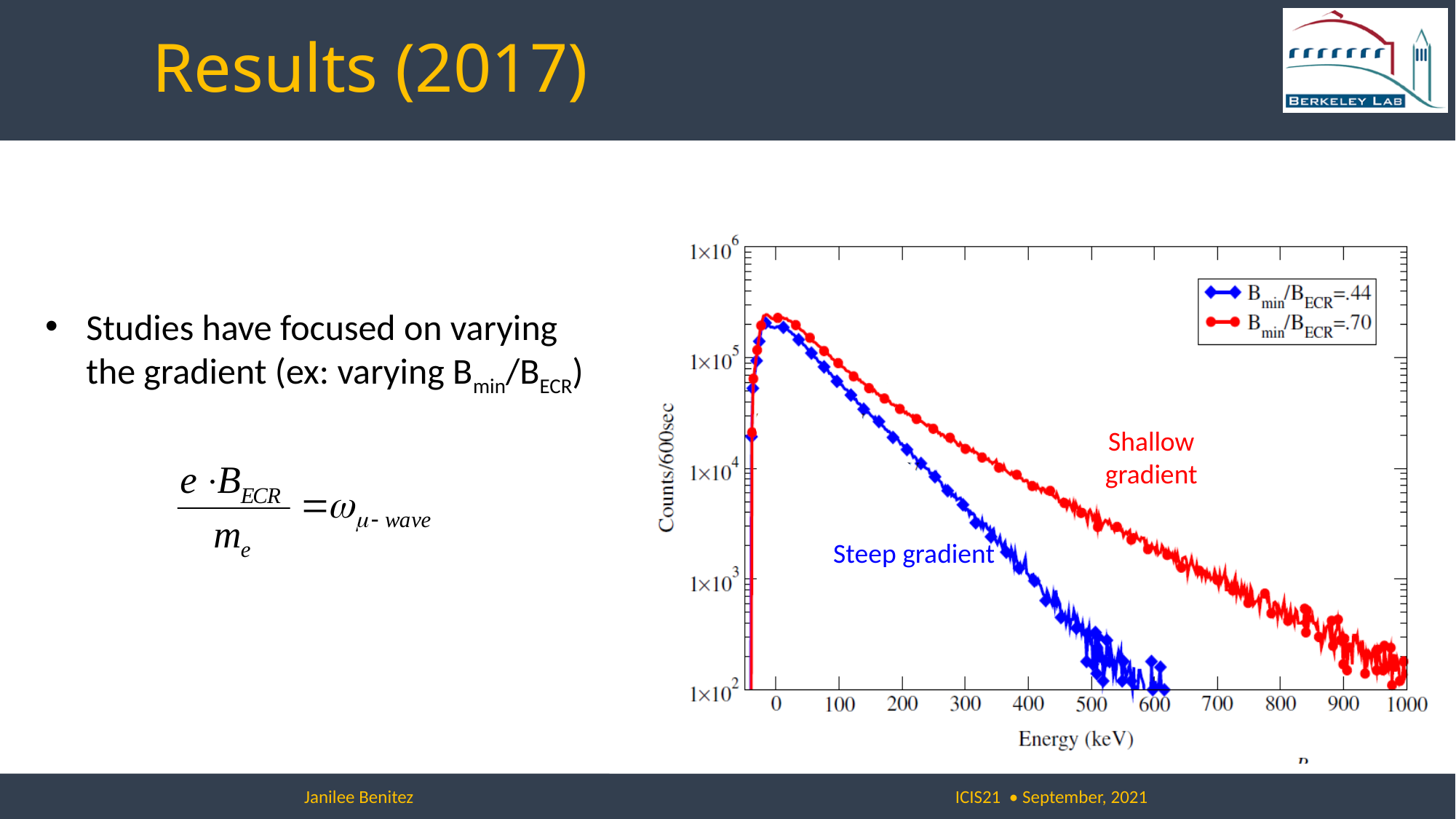
Is the value of the Bmin/BECR=.70 series at 500 keV greater or less than 1×10^3 counts/600sec? greater Is the value of the Bmin/BECR=.44 series at 200 keV greater or less than 1×10^4 counts/600sec? greater What is the label of the y axis of the chart? Counts/600sec Is the value of the Bmin/BECR=.44 series at 500 keV greater or less than 1×10^3 counts/600sec? less Which series extends to higher energies before dropping to the bottom of the plot? Bmin/BECR=.70 At 500 keV, which series has the higher counts: Bmin/BECR=.44 or Bmin/BECR=.70? Bmin/BECR=.70 What kind of chart is shown on the slide? line chart What is the label of the x axis of the chart? Energy (keV) Do the counts rise or fall as energy increases beyond the peak near 0 keV? fall Which series is labelled as the steep gradient on the chart? Bmin/BECR=.44 How many series does the chart legend list? 2